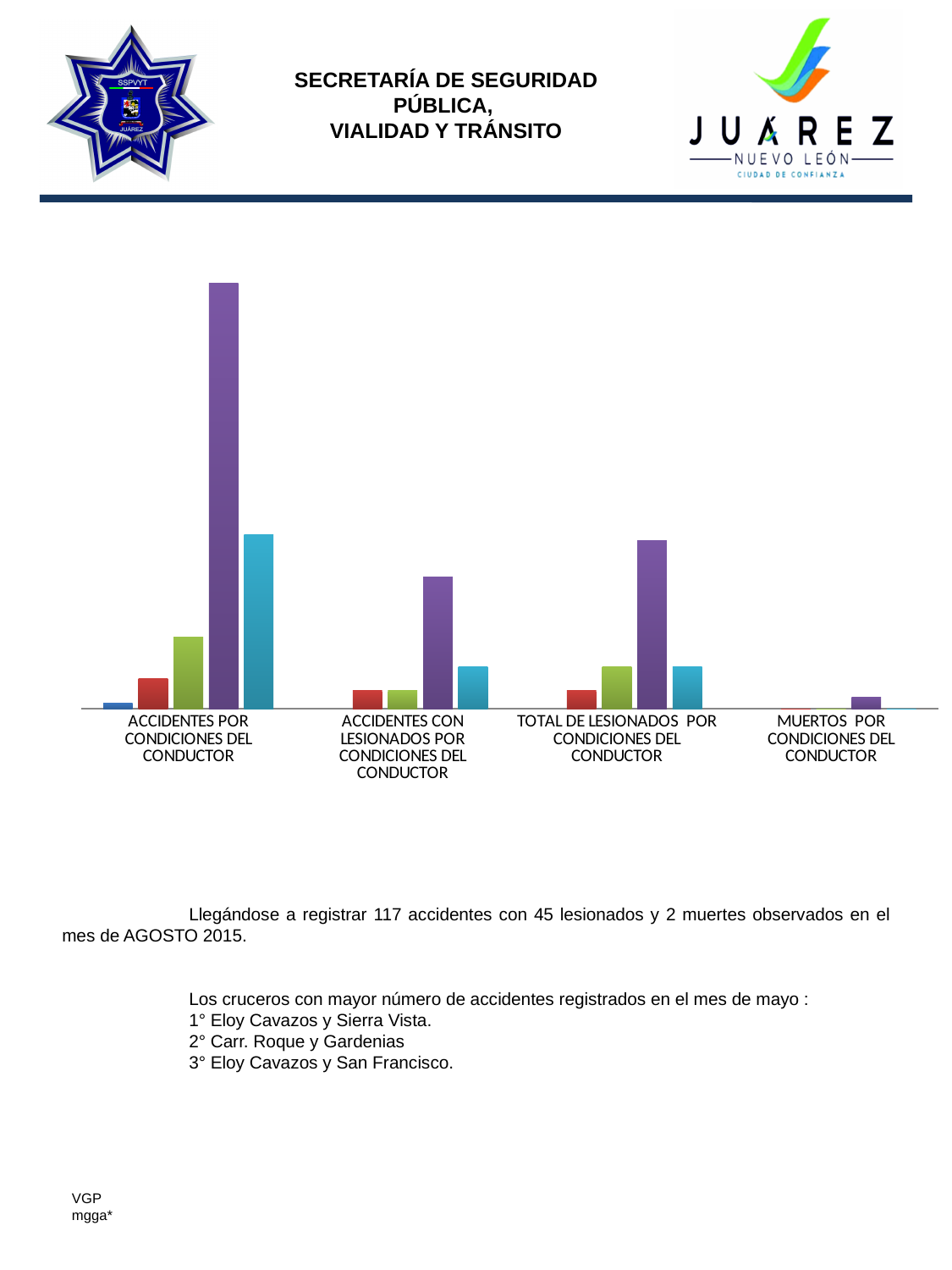
How many bars are plotted for the ACCIDENTES POR CONDICIONES DEL CONDUCTOR category? 5 In the TOTAL DE LESIONADOS POR CONDICIONES DEL CONDUCTOR category, which bar is tallest: the purple bar or the green bar? The purple bar Which is taller: the tallest bar in ACCIDENTES CON LESIONADOS POR CONDICIONES DEL CONDUCTOR or the tallest bar in TOTAL DE LESIONADOS POR CONDICIONES DEL CONDUCTOR? TOTAL DE LESIONADOS POR CONDICIONES DEL CONDUCTOR Does the chart display a legend identifying the series? No What colour is the tallest bar in the chart? Purple How many categories are shown along the x axis of the chart? 4 Which is taller: the tallest bar in ACCIDENTES POR CONDICIONES DEL CONDUCTOR or the tallest bar in MUERTOS POR CONDICIONES DEL CONDUCTOR? ACCIDENTES POR CONDICIONES DEL CONDUCTOR Which category has the lowest bars overall in the chart? MUERTOS POR CONDICIONES DEL CONDUCTOR Which category contains the tallest bar in the chart? ACCIDENTES POR CONDICIONES DEL CONDUCTOR What kind of chart is shown on the slide? Bar chart